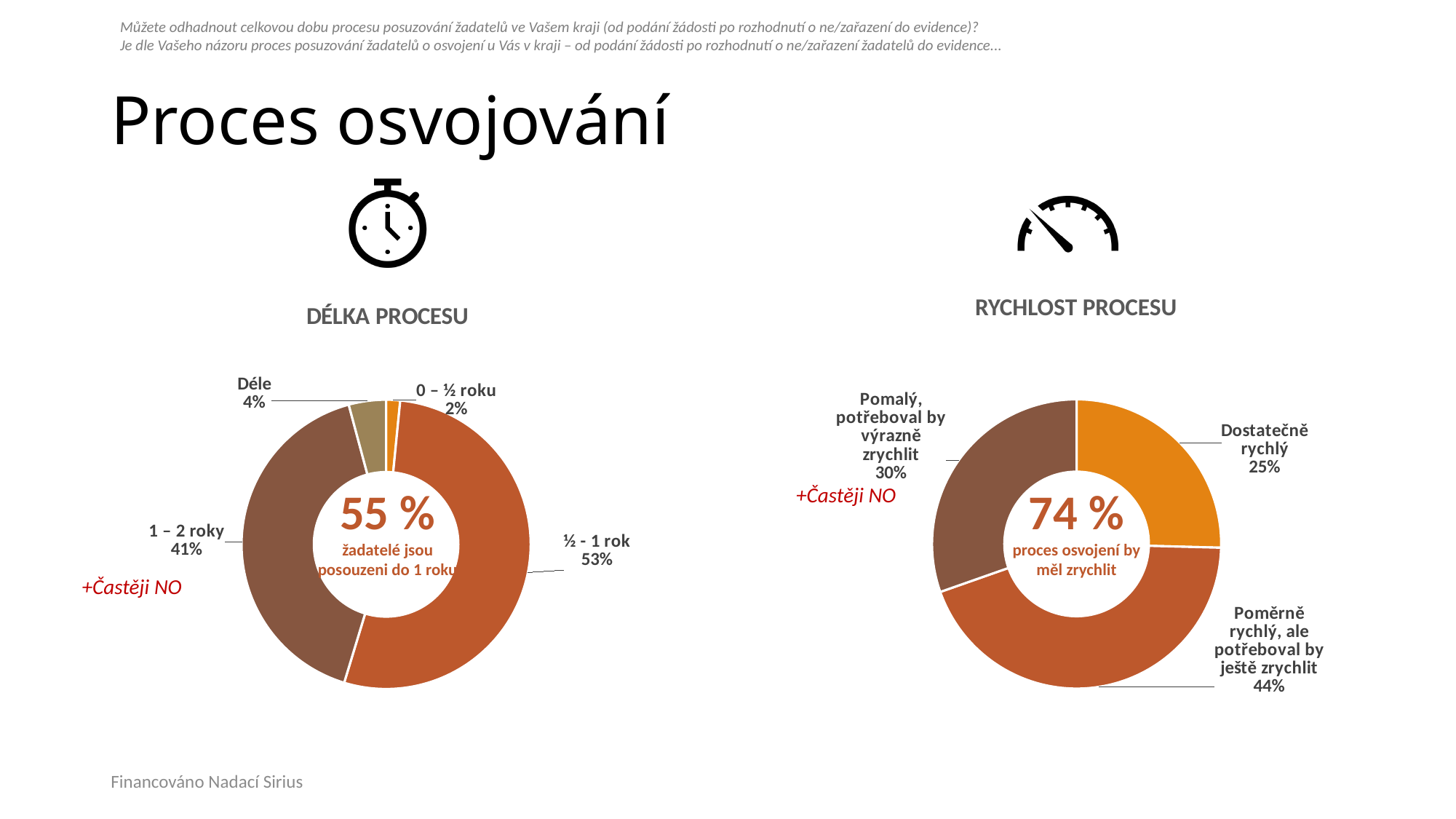
In the RYCHLOST PROCESU chart, which category has the largest share? Poměrně rychlý, ale potřeboval by ještě zrychlit In the DÉLKA PROCESU chart, what share of respondents answered ½ - 1 rok? 53% In the RYCHLOST PROCESU chart, what share of respondents answered Pomalý, potřeboval by výrazně zrychlit? 30% In the DÉLKA PROCESU chart, which category has the smallest share? 0 – ½ roku In the RYCHLOST PROCESU chart, what share of respondents answered Dostatečně rychlý? 25% What percentage is printed in the centre of the RYCHLOST PROCESU chart? 74 % In the DÉLKA PROCESU chart, what share of respondents answered 1 – 2 roky? 41% In the DÉLKA PROCESU chart, what is the difference between the shares for ½ - 1 rok and 1 – 2 roky? 12 percentage points What type of chart is the RYCHLOST PROCESU chart? Doughnut (pie) chart In the DÉLKA PROCESU chart, how many categories are shown? 4 In the RYCHLOST PROCESU chart, which is larger: the share for Dostatečně rychlý or for Pomalý, potřeboval by výrazně zrychlit? Pomalý, potřeboval by výrazně zrychlit In the DÉLKA PROCESU chart, which category has the largest share? ½ - 1 rok